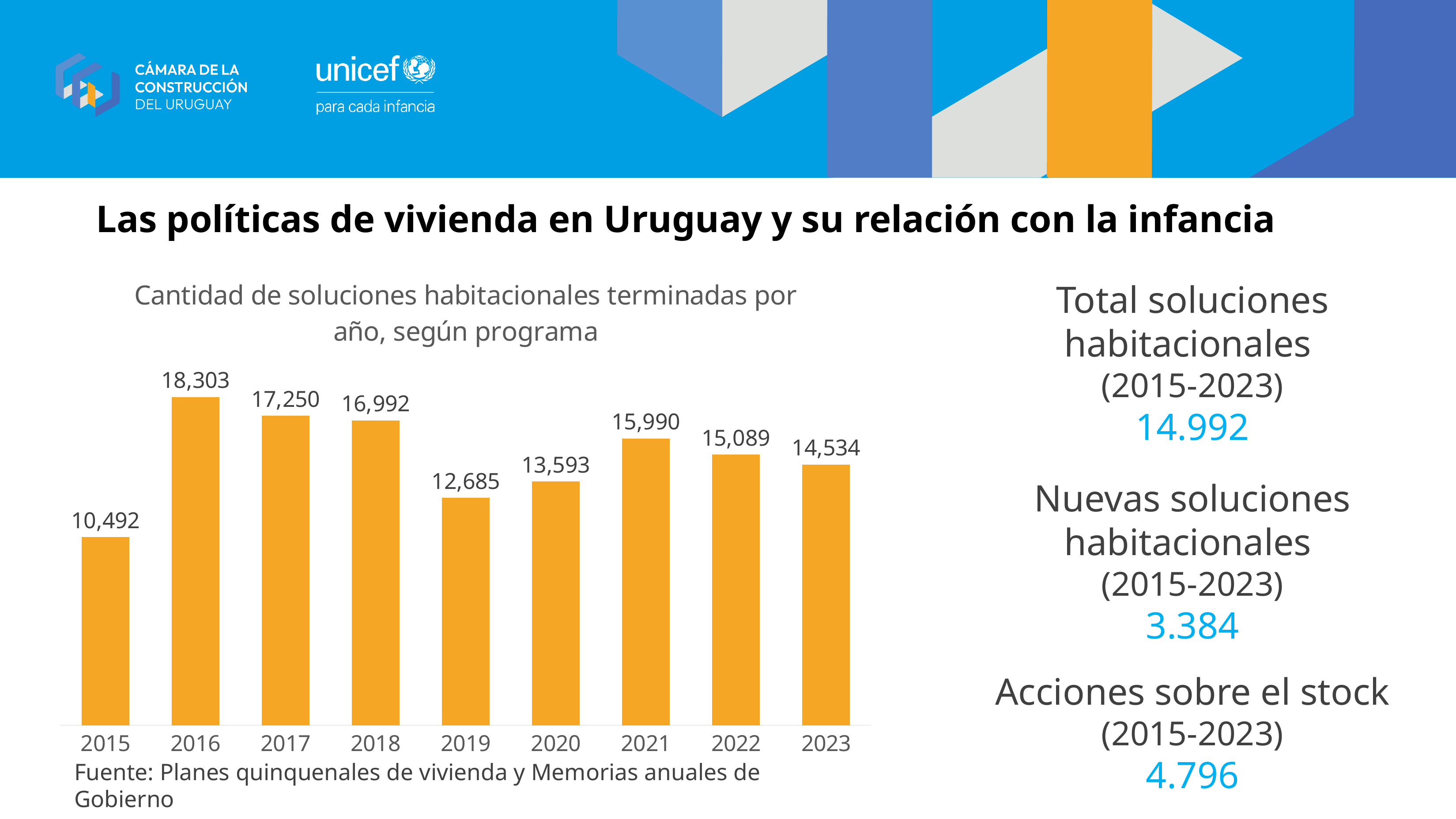
Which is larger, the value for 2019 or the value for 2022? 2022 What is the difference between the values for 2016 and 2015? 7,811 What is the value for 2016? 18,303 What is the value for 2023? 14,534 What kind of chart is shown on the slide? bar chart Which year has the lowest value? 2015 Which year has the highest value? 2016 How many years are shown on the x axis? 9 What is the difference between the values for 2021 and 2020? 2,397 Which is larger, the value for 2017 or the value for 2018? 2017 What is the value for 2019? 12,685 What is the title of the chart? Cantidad de soluciones habitacionales terminadas por año, según programa